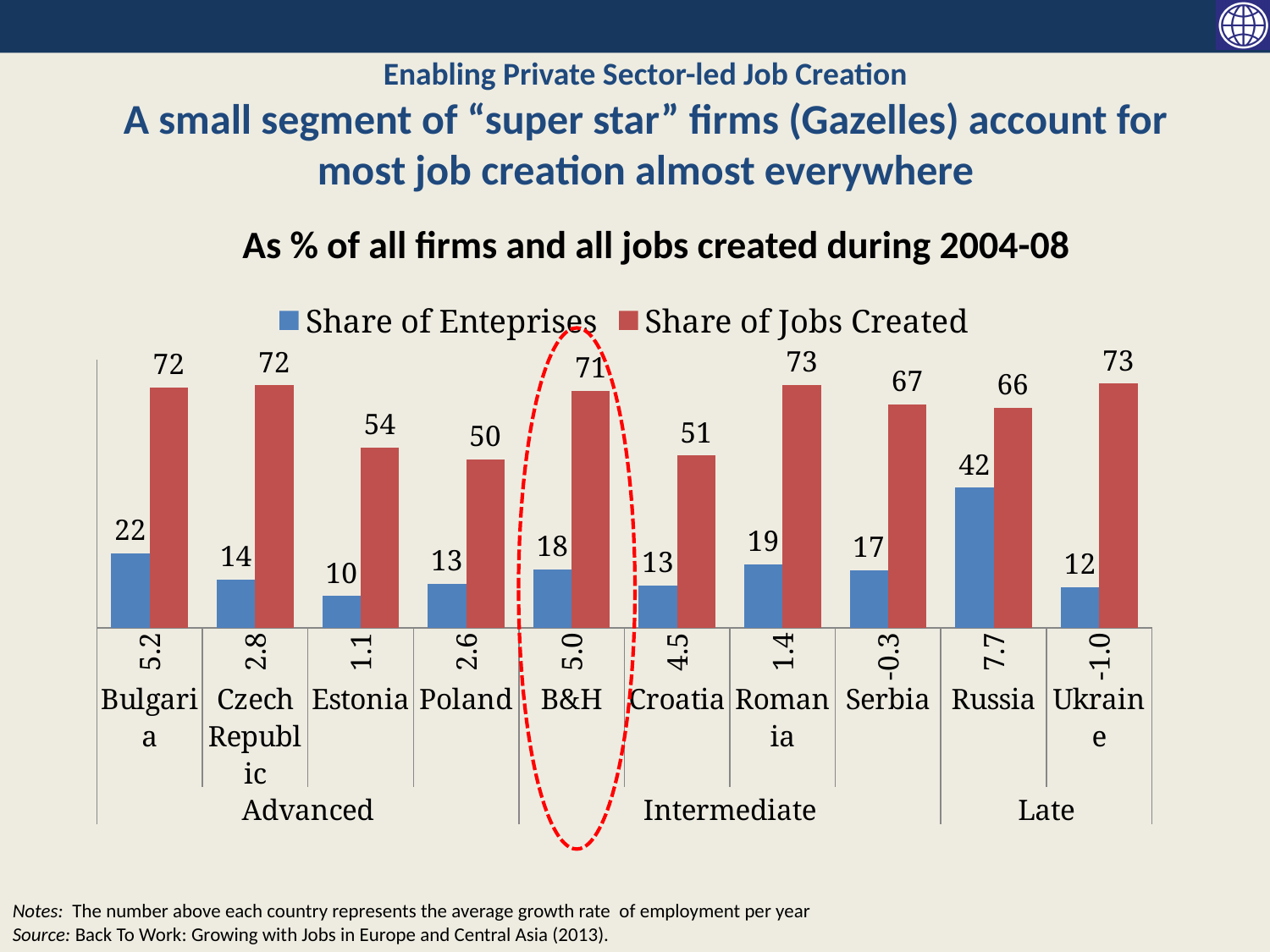
What is the Share of Jobs Created for B&H? 71 What kind of chart is shown on the slide? Bar chart What is the average growth rate of employment per year shown for Serbia? -0.3 Which country has the lowest Share of Enteprises? Estonia How many series does the legend list? 2 Which is larger, the Share of Enteprises for Bulgaria or for Russia? Russia How many countries are shown in the chart? 10 What is the difference between the Share of Jobs Created and the Share of Enteprises for Russia? 24 What is the Share of Enteprises for Russia? 42 What is the Share of Jobs Created for Poland? 50 Which country has the highest Share of Enteprises? Russia Which country has the lowest Share of Jobs Created? Poland